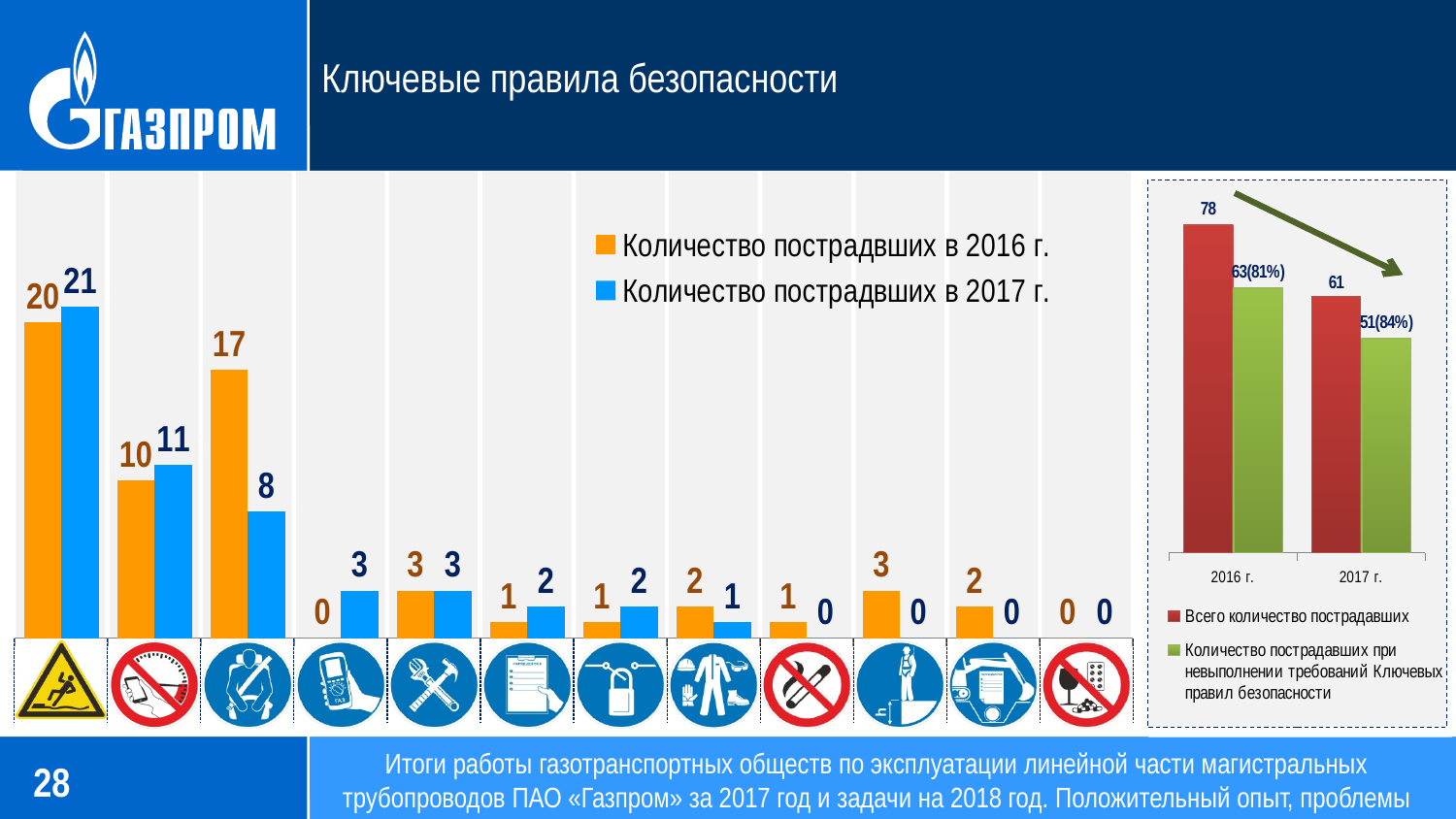
In the chart on the right, does «Всего количество пострадавших» rise or fall from 2016 г. to 2017 г.? fall In the large chart on the left, what is the highest value in the «Количество пострадавших в 2017 г.» series? 21 In the chart on the right, what label is shown on the green bar for 2017 г.? 51(84%) In the large chart on the left, how many series does the legend list? 2 In the large chart on the left, what is the highest value in the «Количество пострадавших в 2016 г.» series? 20 In the chart on the right, what label is shown on the green bar for 2016 г.? 63(81%) In the chart on the right, how many series does the legend list? 2 In the chart on the right, by how much did «Всего количество пострадавших» decrease from 2016 г. to 2017 г.? 17 In the chart on the right, what is the value of «Всего количество пострадавших» for 2016 г.? 78 What kind of chart is the chart on the right? bar chart In the chart on the right, what is the value of «Всего количество пострадавших» for 2017 г.? 61 In the large chart on the left, how many categories (icons) are shown along the x axis? 12